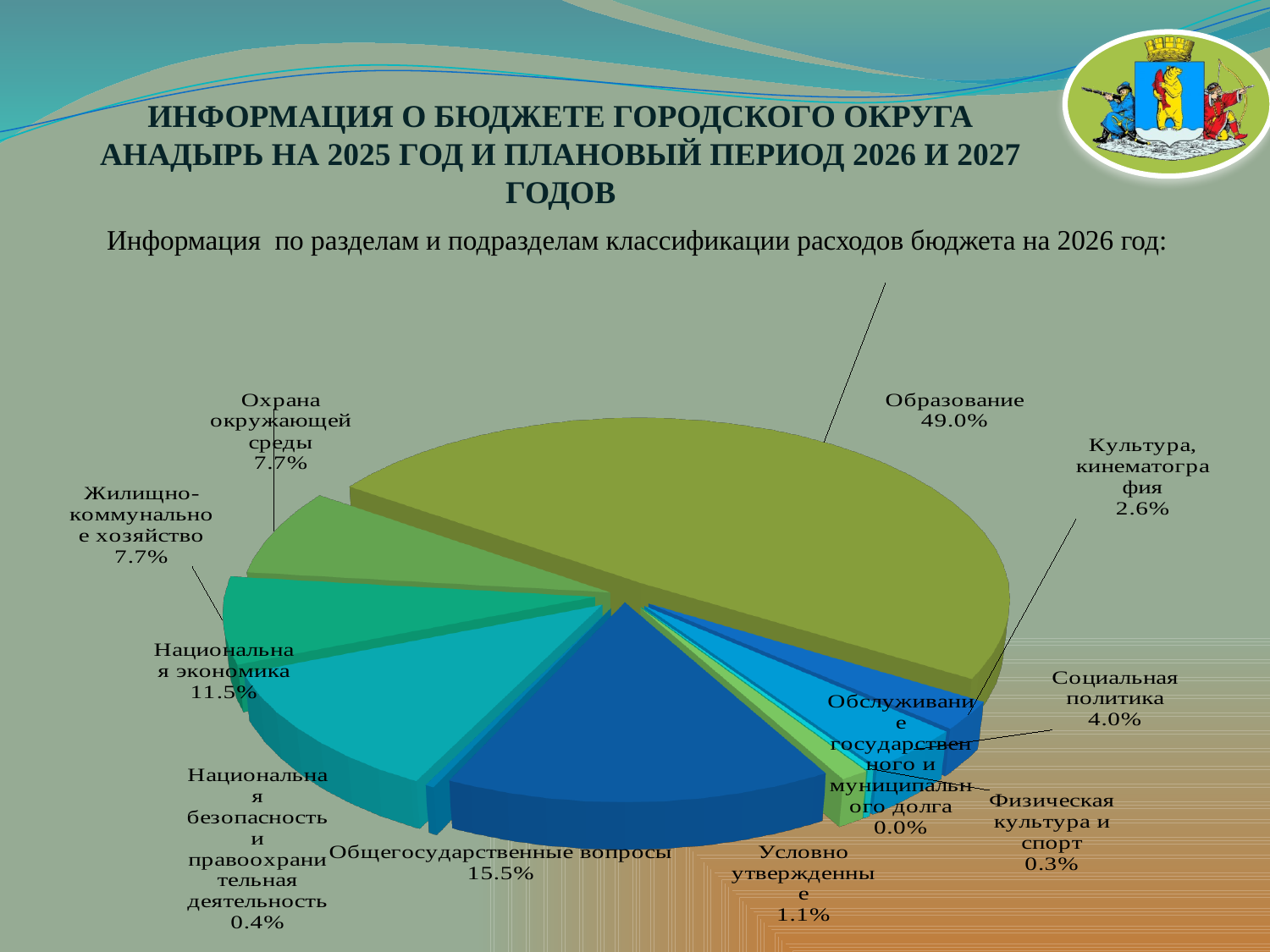
Which section has the largest share of the pie? Образование What percentage is shown for Национальная экономика? 11.5% Which is larger: the share for Национальная экономика or the share for Жилищно-коммунальное хозяйство? Национальная экономика What share of the 2026 budget expenditures goes to Образование? 49.0% What percentage is shown for Социальная политика? 4.0% Which section has the smallest share of the pie? Обслуживание государственного и муниципального долга What type of chart is shown on the slide? pie chart What percentage is shown for Условно утвержденные? 1.1% What is the difference in percentage points between Образование and Общегосударственные вопросы? 33.5 For which year does the chart show the breakdown of budget expenditures by sections and subsections? 2026 How many sections are shown in the pie chart? 11 What percentage is shown for Общегосударственные вопросы? 15.5%